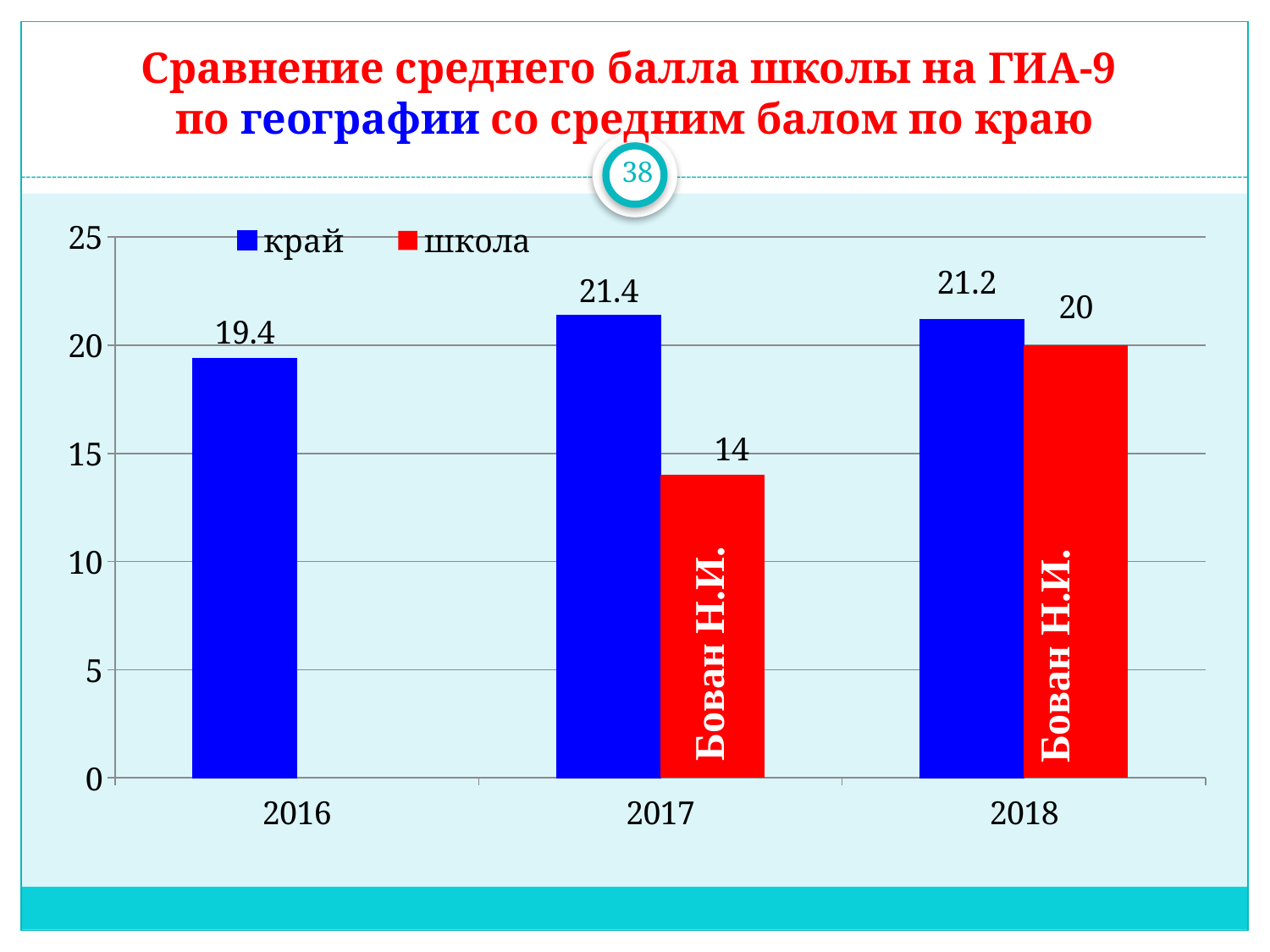
How many series does the legend list? 2 In which year is the край value highest? 2017 What is the value for школа in 2017? 14 What kind of chart is shown on the slide? bar chart What is the value for школа in 2018? 20 What is the value for край in 2016? 19.4 In which year is the край value lowest? 2016 What is the value for край in 2018? 21.2 How many years are shown on the x axis? 3 Which is larger in 2018, край or школа? край What is the difference between the край and школа values in 2018? 1.2 What is the difference between the край and школа values in 2017? 7.4